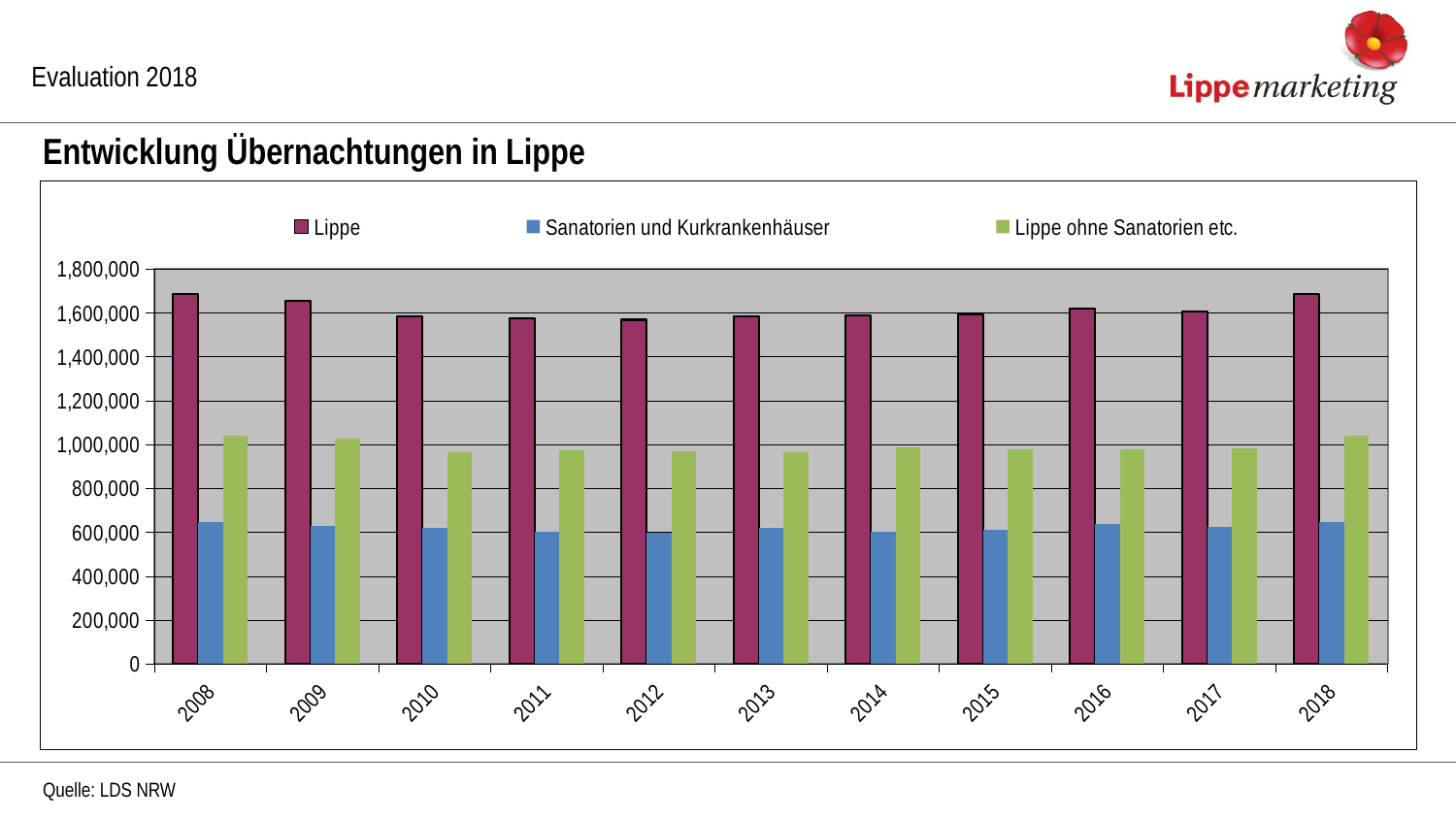
Is the value for Lippe ohne Sanatorien etc. in 2008 greater or less than 1,000,000? greater Which is larger for the Lippe series: the value in 2008 or the value in 2012? 2008 Is the value for Lippe ohne Sanatorien etc. in 2010 greater or less than 1,000,000? less Which series is shown in green in the legend? Lippe ohne Sanatorien etc. Which is larger for Lippe ohne Sanatorien etc.: the value in 2008 or the value in 2010? 2008 Is the value for Lippe in 2008 greater or less than 1,600,000? greater How many series does the legend list? 3 How many years are shown on the x axis? 11 What is the title of the chart? Entwicklung Übernachtungen in Lippe What kind of chart is shown on the slide? bar chart